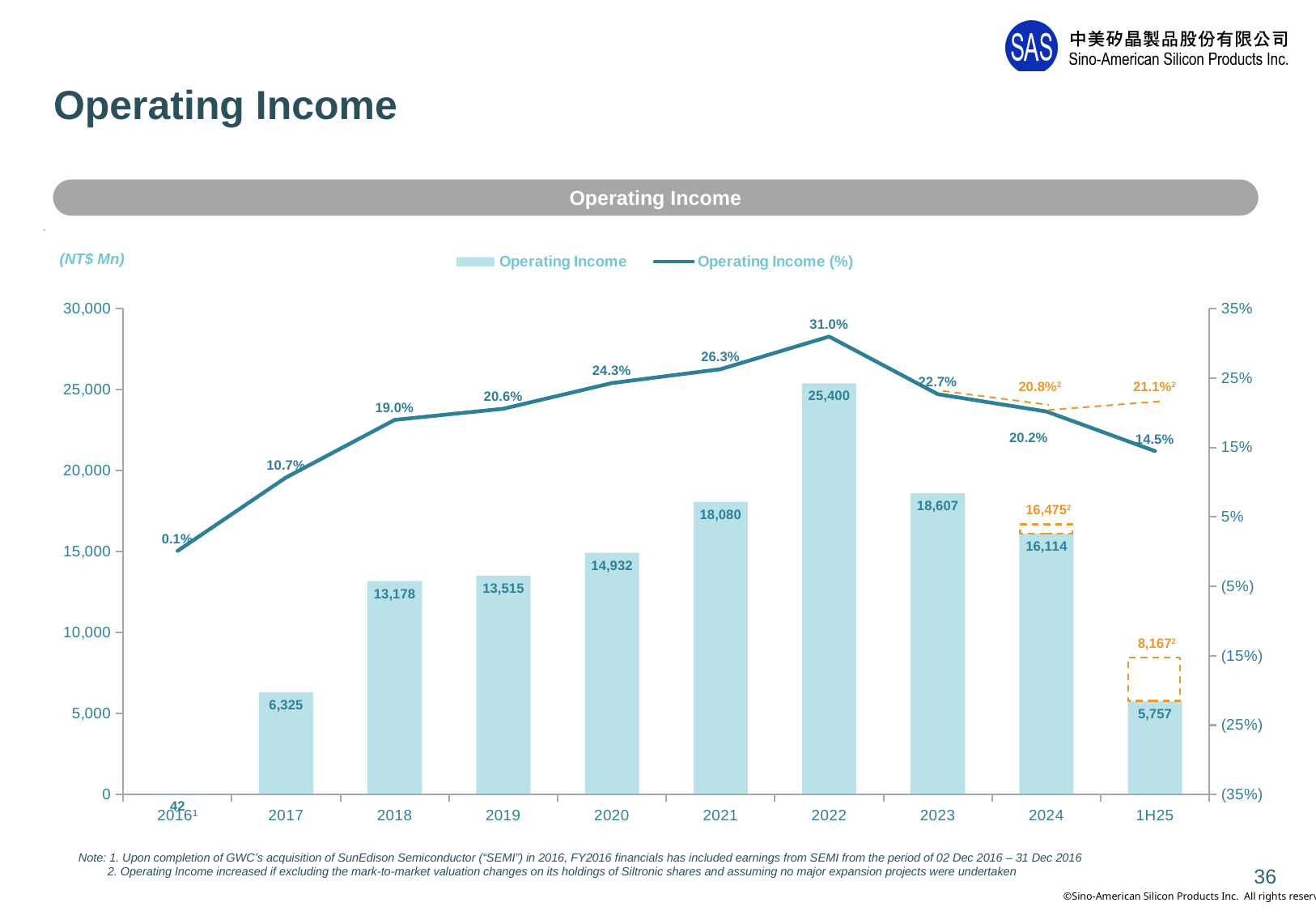
What is the difference in Operating Income between 2023 and 2024? 2,493 How many years or periods are shown on the x axis? 10 Which year has the highest Operating Income? 2022 What is the Operating Income for 1H25? 5,757 Does the Operating Income (%) rise or fall from 2022 to 1H25? Fall Which is larger, the Operating Income for 2018 or for 2019? 2019 Is the Operating Income for 2020 greater or less than 15,000? less How many series does the legend list? 2 What is the Operating Income (%) for 2021? 26.3% What kind of chart is used to show Operating Income in NT$ Mn? Bar chart What is the Operating Income for 2022? 25,400 Which year has the lowest Operating Income (%)? 2016